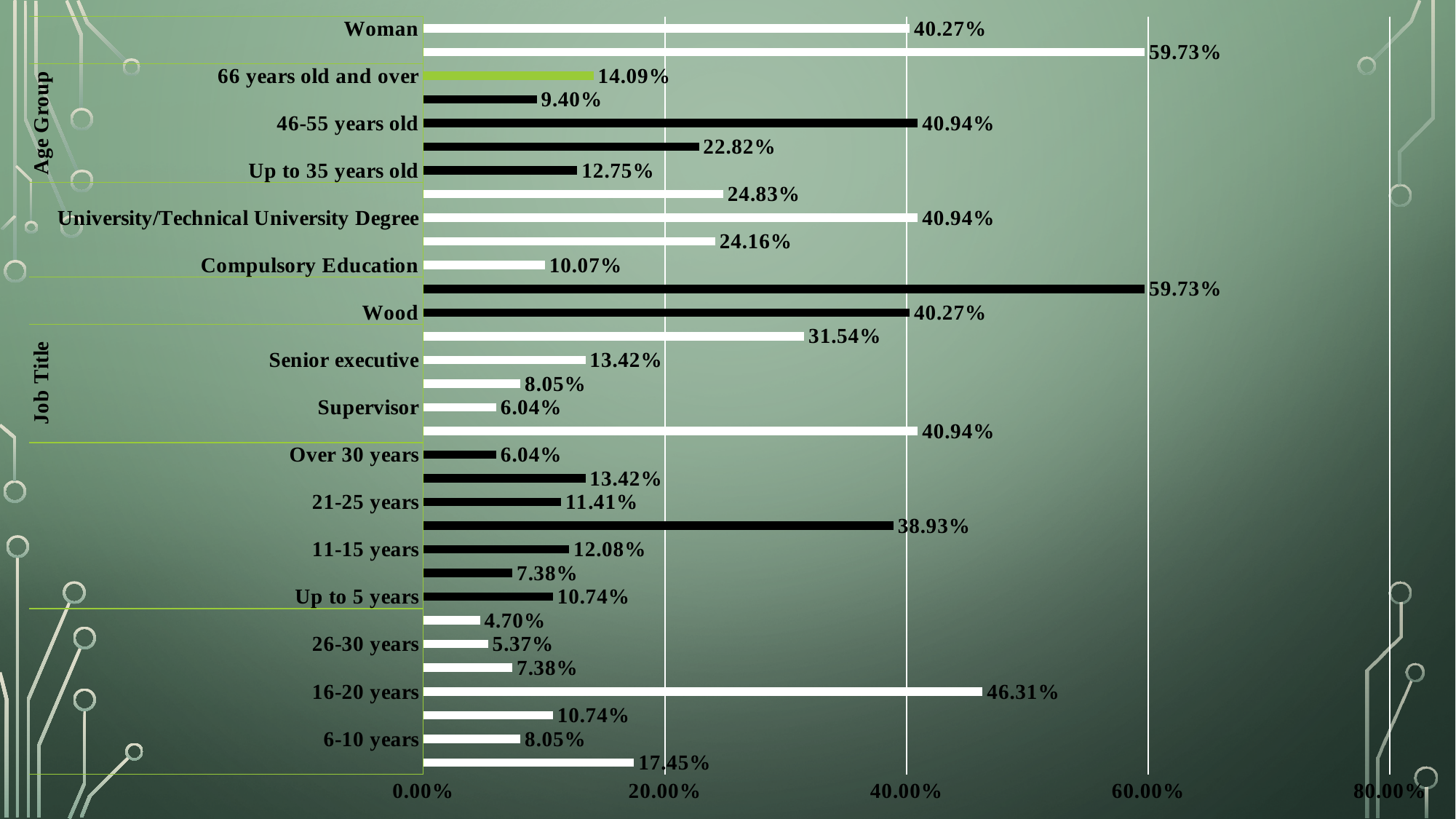
What is the difference between the value for Senior executive and the value for Over 30 years? 7.38% What is the value shown for University/Technical University Degree? 40.94% What is the value shown for 66 years old and over? 14.09% Which is larger, the value for 46-55 years old or the value for Up to 35 years old? 46-55 years old What is the value shown for 16-20 years? 46.31% Is the value for Wood greater or less than 20.00%? greater What is the difference between the value for 16-20 years and the value for 46-55 years old? 5.37% What is the value shown for Woman? 40.27% Which is larger, the value for Senior executive or the value for Supervisor? Senior executive What is the value shown for Compulsory Education? 10.07% What kind of chart is shown on the slide? Bar chart What is the value shown for Supervisor? 6.04%